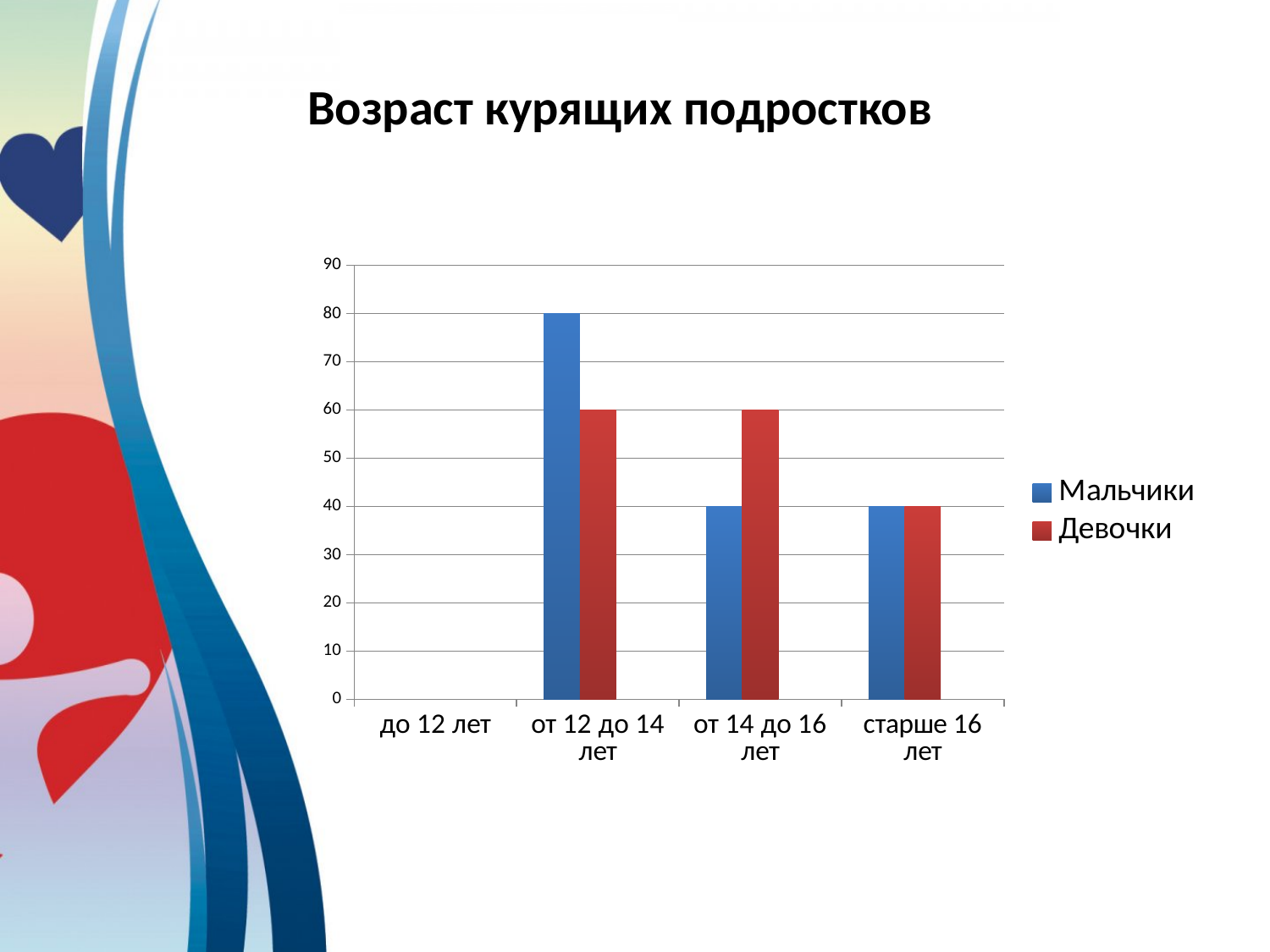
What is the difference between Мальчики and Девочки in the category от 12 до 14 лет? 20 Which is larger in the category от 14 до 16 лет: Мальчики or Девочки? Девочки How many series does the legend list? 2 What type of chart is shown on the slide? bar chart What is the title of the chart? Возраст курящих подростков What is the value for Девочки in the category от 14 до 16 лет? 60 What is the value for Мальчики in the category старше 16 лет? 40 What is the value for Мальчики in the category от 12 до 14 лет? 80 Do the values for Мальчики rise or fall from от 12 до 14 лет to от 14 до 16 лет? fall How many age categories are shown on the x axis? 4 In which category is the value for Мальчики highest? от 12 до 14 лет Which series is shown in blue? Мальчики